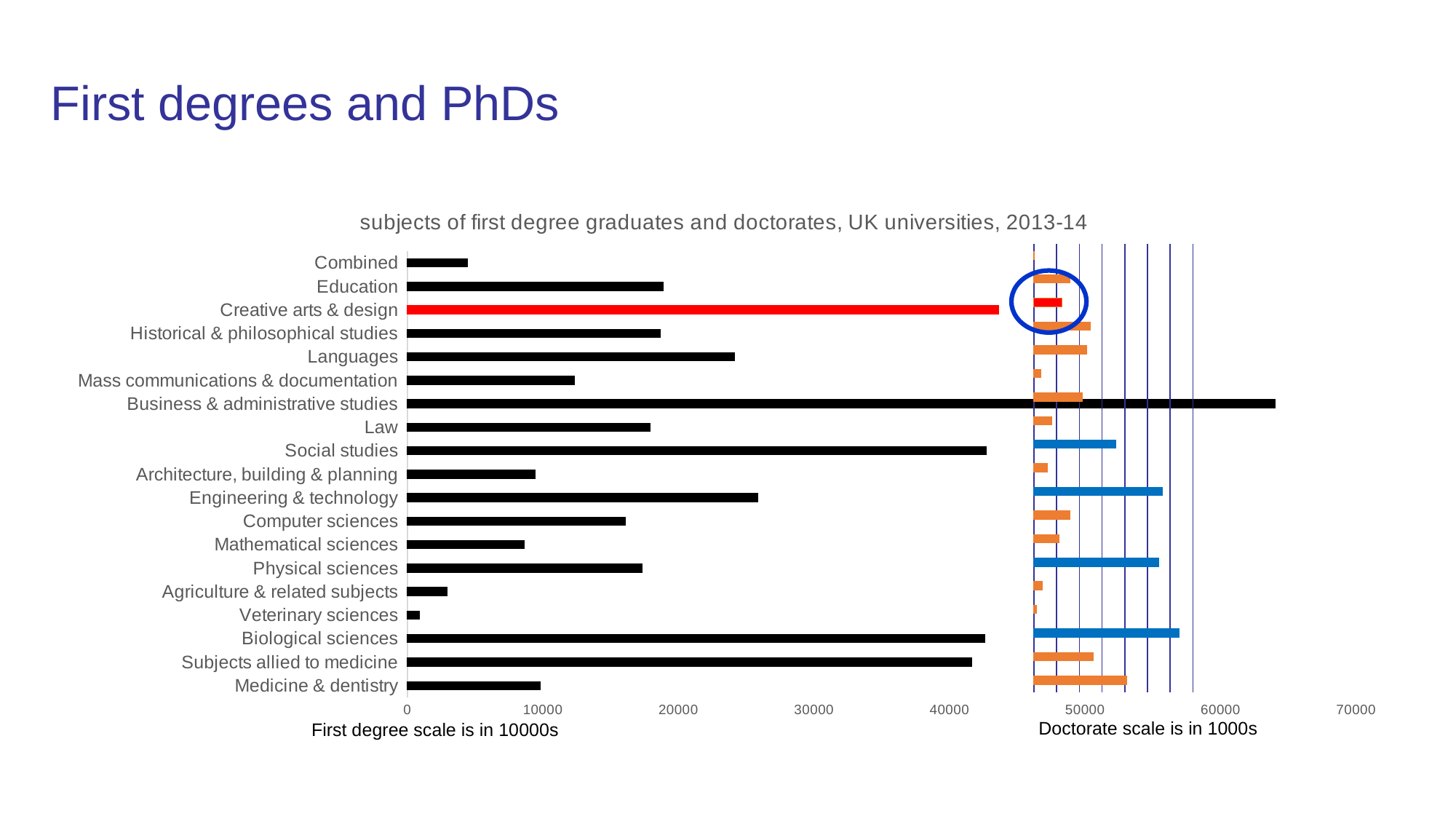
Is the first degree value for Agriculture & related subjects greater or less than 10000? less What is the title of the chart? subjects of first degree graduates and doctorates, UK universities, 2013-14 Which subject has the shortest first degree bar? Veterinary sciences Which has the larger first degree bar, Engineering & technology or Computer sciences? Engineering & technology Is the first degree value for Combined greater or less than 10000? less Is the first degree value for Social studies greater or less than 40000? greater Which subject has the longest first degree bar? Business & administrative studies How many subject categories are listed on the chart? 19 What kind of chart is shown on the slide? bar chart Which has the larger first degree bar, Languages or Education? Languages